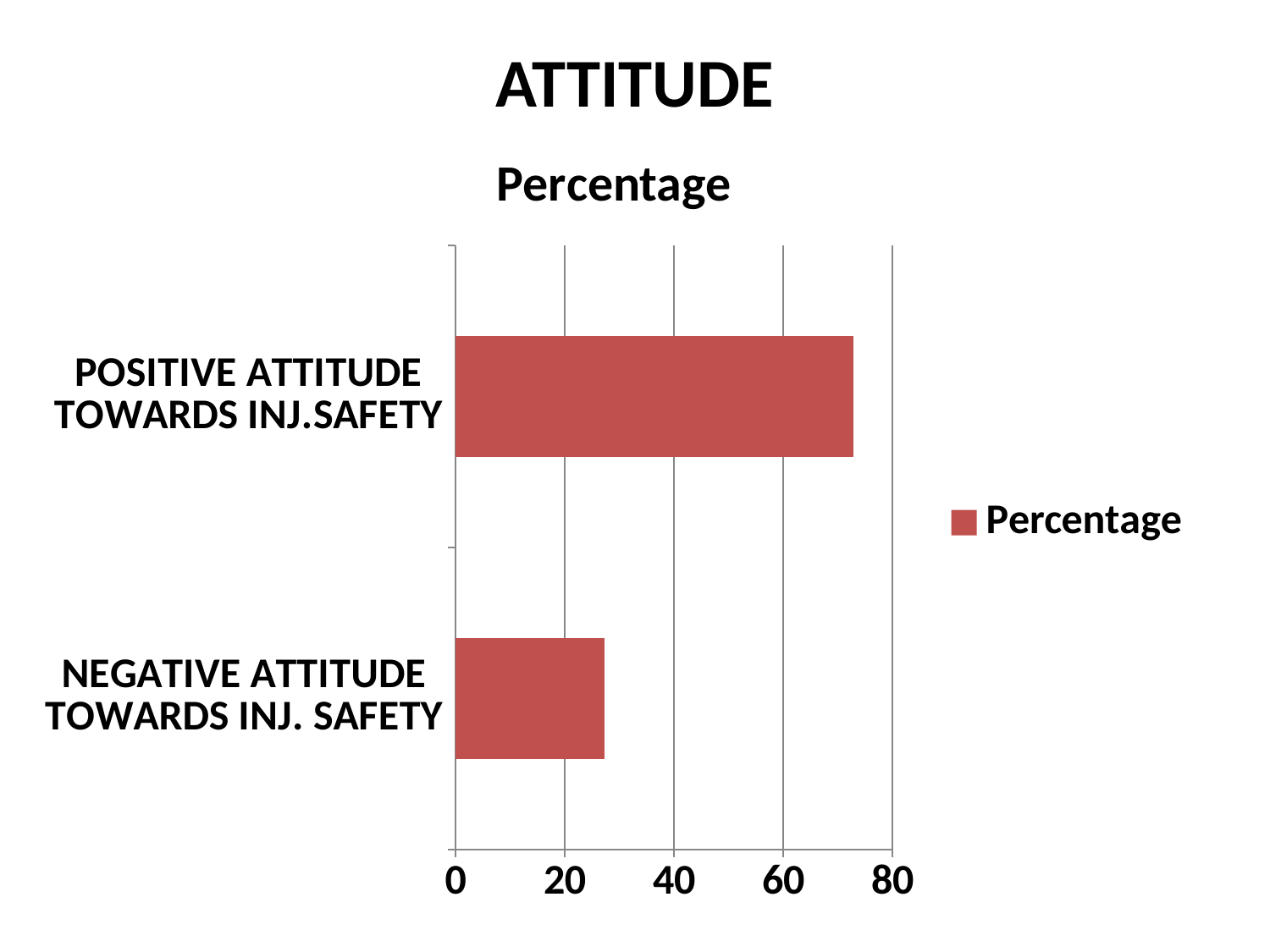
What is the name of the series shown in the legend? Percentage Is the value for NEGATIVE ATTITUDE TOWARDS INJ. SAFETY greater or less than 20? greater Is the value for NEGATIVE ATTITUDE TOWARDS INJ. SAFETY greater or less than 40? less How many categories are plotted in the chart? 2 Is the value for POSITIVE ATTITUDE TOWARDS INJ.SAFETY greater or less than 80? less Which is larger: the value for POSITIVE ATTITUDE TOWARDS INJ.SAFETY or NEGATIVE ATTITUDE TOWARDS INJ. SAFETY? POSITIVE ATTITUDE TOWARDS INJ.SAFETY Which category has the highest value? POSITIVE ATTITUDE TOWARDS INJ.SAFETY Which category has the lowest value? NEGATIVE ATTITUDE TOWARDS INJ. SAFETY What is the title of the chart? Percentage What type of chart is shown on the slide? bar chart How many series does the legend list? 1